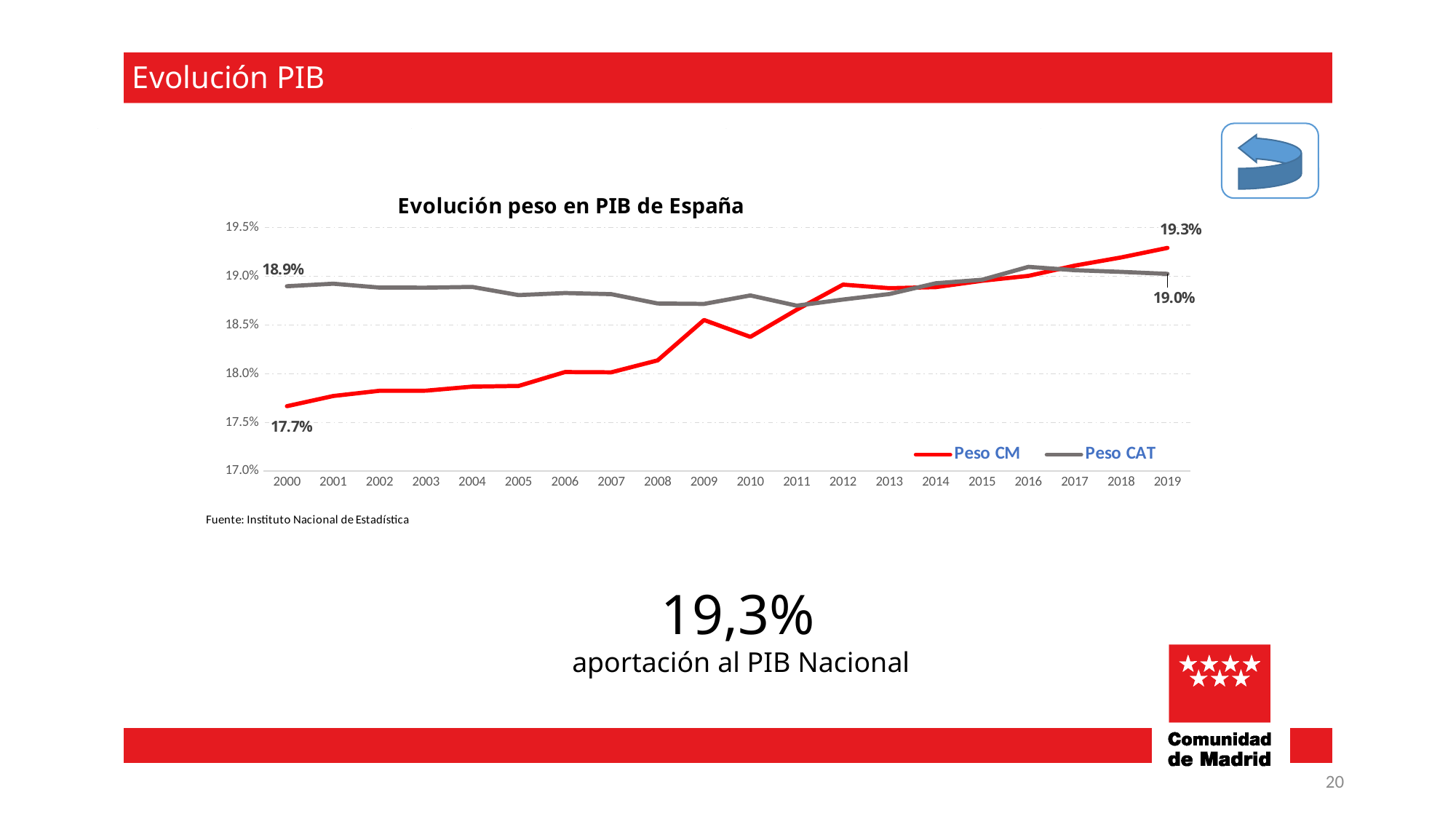
Which series has the higher value in 2019, Peso CM or Peso CAT? Peso CM Is the value for Peso CM in 2005 greater or less than 18.0%? less What is the value of Peso CM in 2000? 17.7% What is the value of Peso CAT in 2000? 18.9% What is the difference between the Peso CM values in 2019 and 2000? 1.6% What is the value of Peso CM in 2019? 19.3% How many series does the legend list? 2 Does the Peso CM series generally rise or fall from 2000 to 2019? Rise What kind of chart is shown on the slide? Line chart Which series has the higher value in 2000, Peso CM or Peso CAT? Peso CAT What is the value of Peso CAT in 2019? 19.0% Is the value for Peso CM in 2009 greater or less than 18.5%? greater